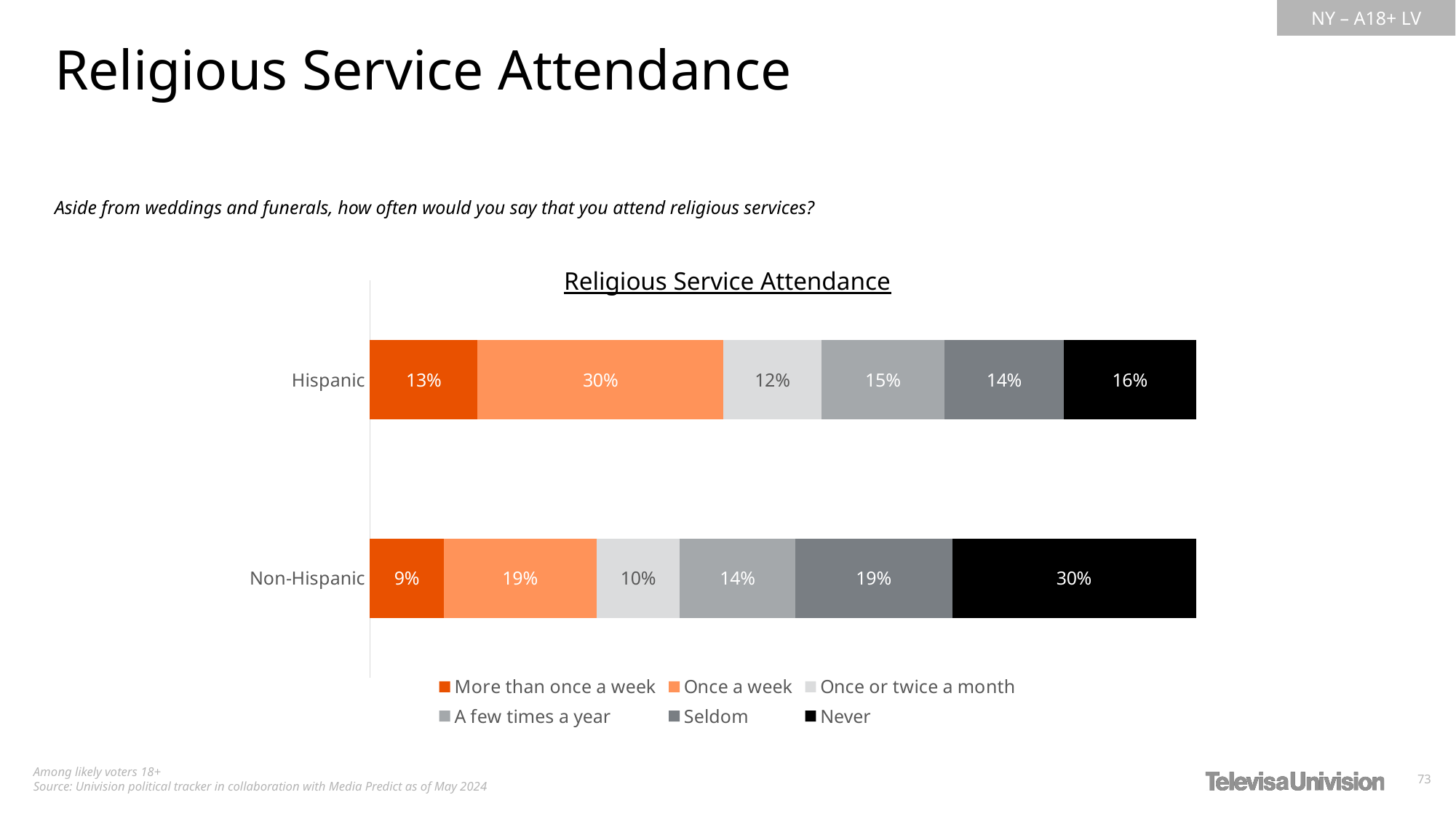
What percentage of Hispanic respondents attend religious services more than once a week? 13% What percentage of Non-Hispanic respondents attend religious services once or twice a month? 10% What is the total of the Hispanic bar's segments? 100% What percentage of Non-Hispanic respondents say they never attend religious services? 30% How many groups (bars) are shown in the chart? 2 What percentage of Hispanic respondents attend religious services once a week? 30% Which attendance category has the smallest share among Non-Hispanic respondents? More than once a week Which group has a larger share attending religious services once a week, Hispanic or Non-Hispanic? Hispanic How many series does the legend list? 6 What is the difference between the Non-Hispanic and Hispanic shares for 'Never'? 14 percentage points Which attendance category has the largest share among Hispanic respondents? Once a week What kind of chart is shown on the slide? Stacked bar chart